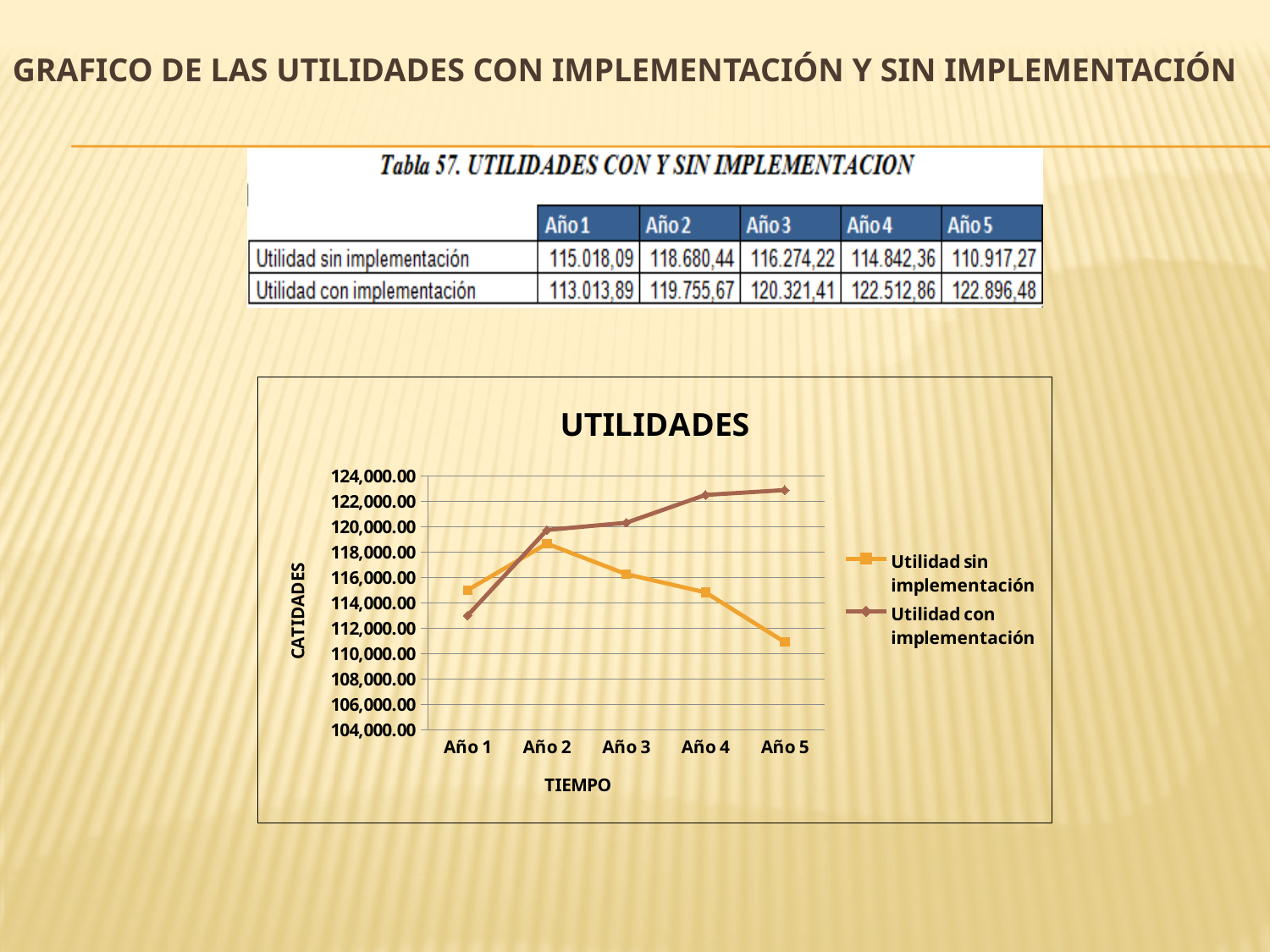
What type of chart is shown under the title UTILIDADES? Line chart Is the value for Utilidad con implementación in Año 4 greater or less than 122,000.00? greater In which year is Utilidad con implementación highest? Año 5 How many years are shown on the x axis of the UTILIDADES chart? 5 According to the table, what is the value of Utilidad sin implementación in Año 1? 115.018,09 In which year is Utilidad sin implementación lowest? Año 5 Is the value for Utilidad sin implementación in Año 5 greater or less than 112,000.00? less How many series does the legend of the UTILIDADES chart list? 2 From Año 2 to Año 5, does Utilidad sin implementación rise or fall? Fall In Año 4, which series has the larger value, Utilidad sin implementación or Utilidad con implementación? Utilidad con implementación What is the label on the x axis of the UTILIDADES chart? TIEMPO According to the table, what is the value of Utilidad con implementación in Año 5? 122.896,48